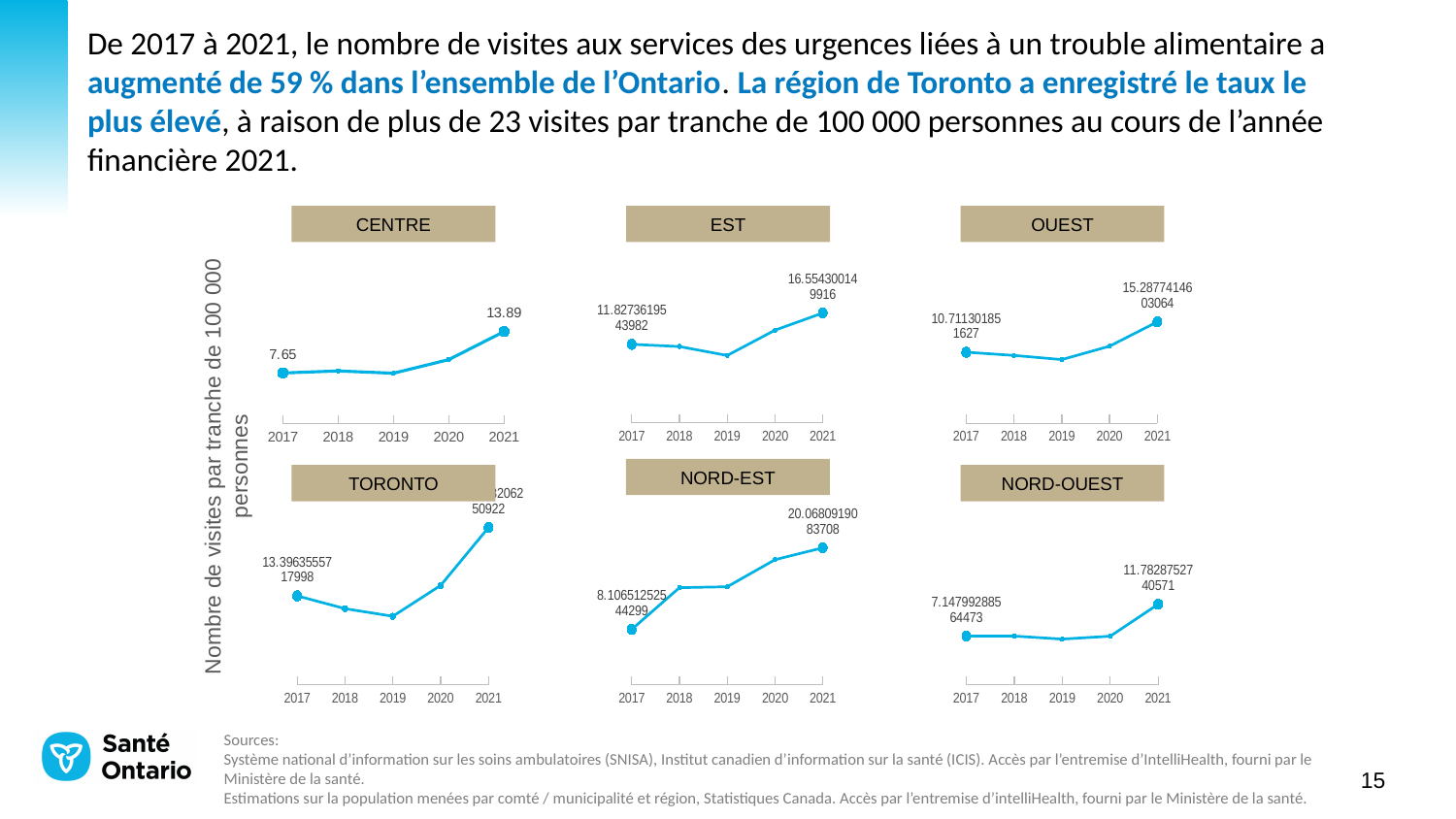
In the CENTRE chart, what is the value for 2021? 13.89 What kind of chart is the OUEST chart? line chart In the NORD-EST chart, do the values rise or fall from 2017 to 2021? rise In the CENTRE chart, what is the difference between the 2021 and 2017 values? 6.24 In the NORD-OUEST chart, which year has the highest value? 2021 In the CENTRE chart, which year has the highest value? 2021 How many years are plotted in the TORONTO chart? 5 How many regional charts are shown on the slide? 6 In the NORD-EST chart, which year has the lowest value? 2017 In the EST chart, which is larger, the value for 2017 or the value for 2021? 2021 What is the label on the shared vertical axis of the charts? Nombre de visites par tranche de 100 000 personnes In the CENTRE chart, what is the value for 2017? 7.65